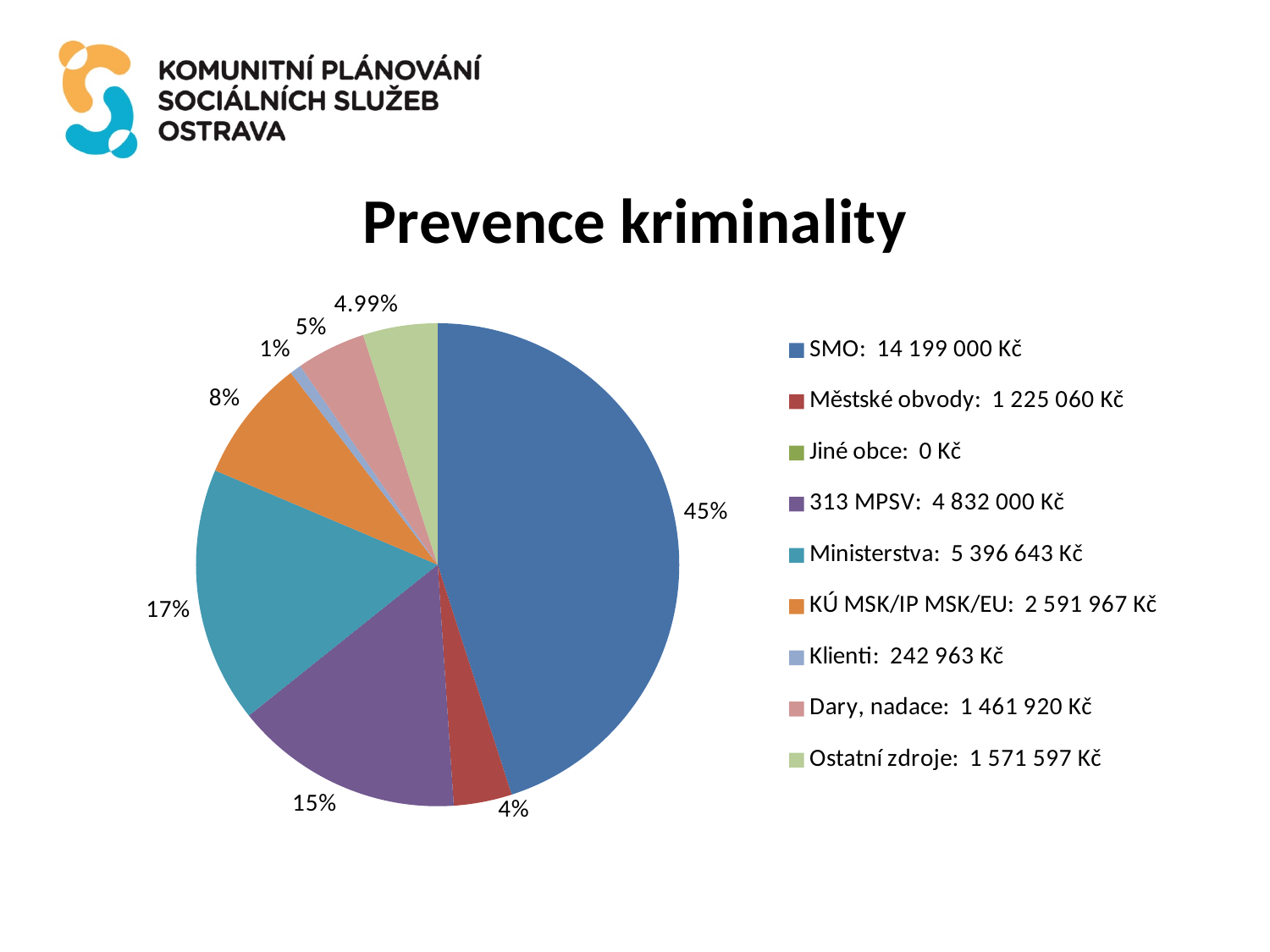
What share of the pie does SMO represent? 45% What share of the pie does 313 MPSV represent? 15% What share of the pie does Ministerstva represent? 17% How many entries does the legend list? 9 What kind of chart is shown on the slide? pie chart What amount in Kč is listed for SMO in the legend? 14 199 000 Kč Which category has the largest slice of the pie? SMO What is the title of the chart? Prevence kriminality Which is larger, the slice for Ministerstva or the slice for 313 MPSV? Ministerstva What amount in Kč is listed for Klienti in the legend? 242 963 Kč What is the difference in Kč between the amounts listed for Ministerstva and 313 MPSV? 564 643 Kč